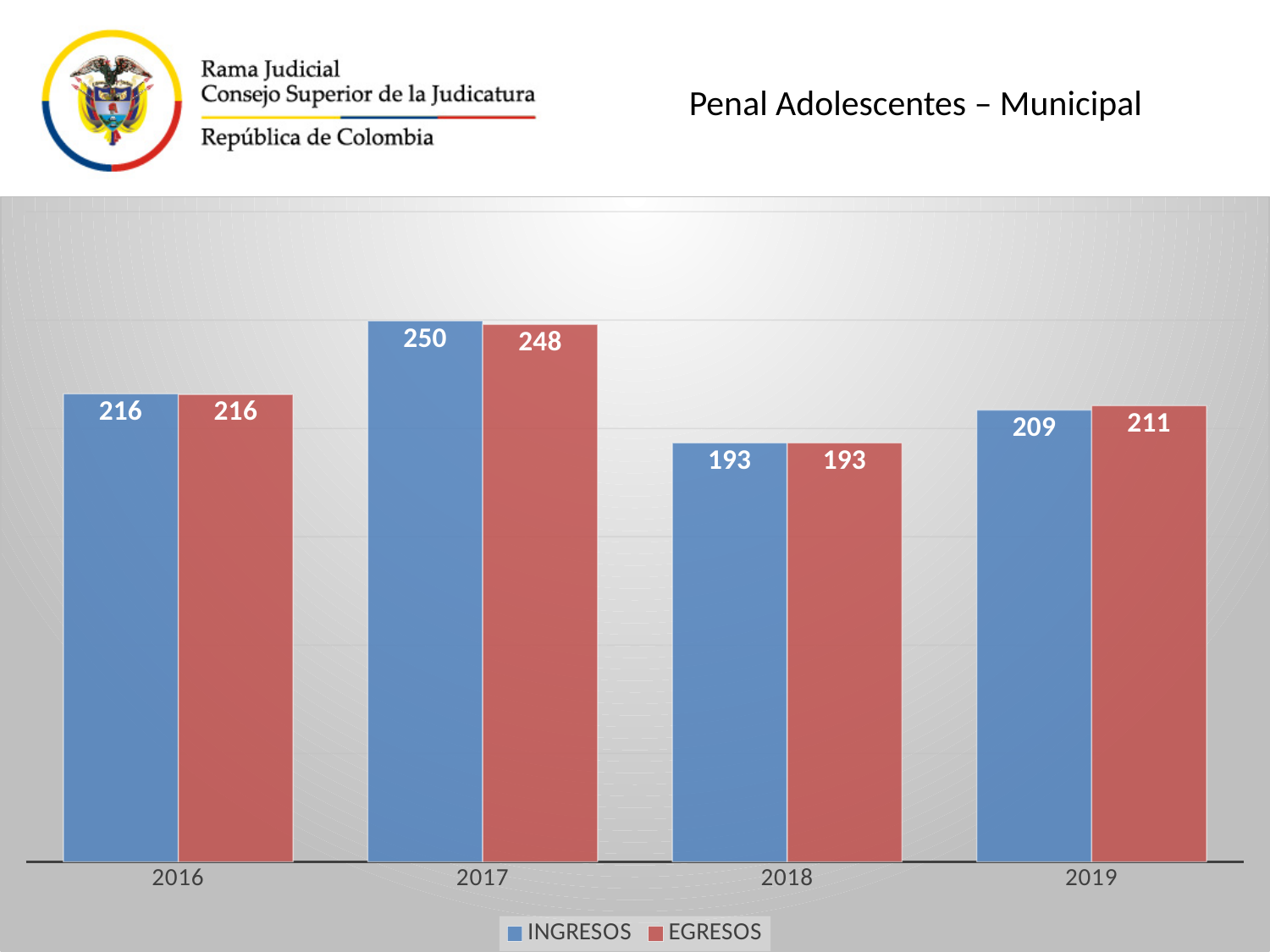
What is the EGRESOS value for 2019? 211 Which year has the lowest EGRESOS value? 2018 What is the difference between INGRESOS and EGRESOS in 2017? 2 How many series does the legend list? 2 Which is larger in 2019, INGRESOS or EGRESOS? EGRESOS Which year has the highest INGRESOS value? 2017 What is the INGRESOS value for 2017? 250 What colour are the EGRESOS bars? Red How many years are shown on the x axis? 4 What kind of chart is shown on the slide? Bar chart What is the EGRESOS value for 2016? 216 What is the difference between the INGRESOS values for 2017 and 2018? 57